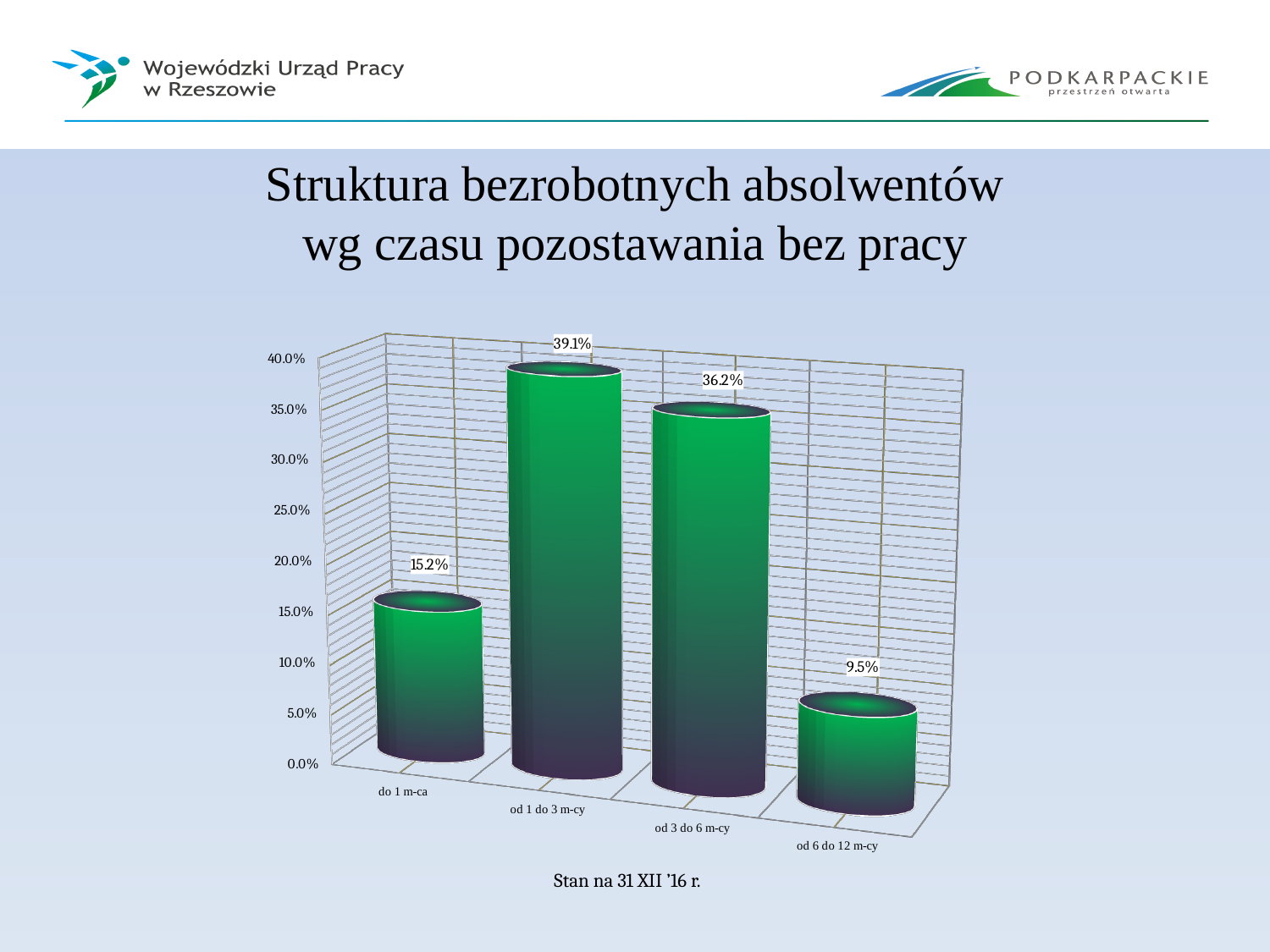
What is the value for the category "od 6 do 12 m-cy"? 9.5% What is the difference between the values for "do 1 m-ca" and "od 6 do 12 m-cy"? 5.7% Which category has the lowest value? od 6 do 12 m-cy Which is larger, the value for "do 1 m-ca" or the value for "od 6 do 12 m-cy"? do 1 m-ca What is the title of the chart on the slide? Struktura bezrobotnych absolwentów wg czasu pozostawania bez pracy What is the difference between the values for "od 1 do 3 m-cy" and "od 3 do 6 m-cy"? 2.9% How many categories are shown on the x axis? 4 Which category has the highest value? od 1 do 3 m-cy What kind of chart is shown on the slide? bar chart What is the value for the category "do 1 m-ca"? 15.2% What is the value for the category "od 1 do 3 m-cy"? 39.1% What is the value for the category "od 3 do 6 m-cy"? 36.2%